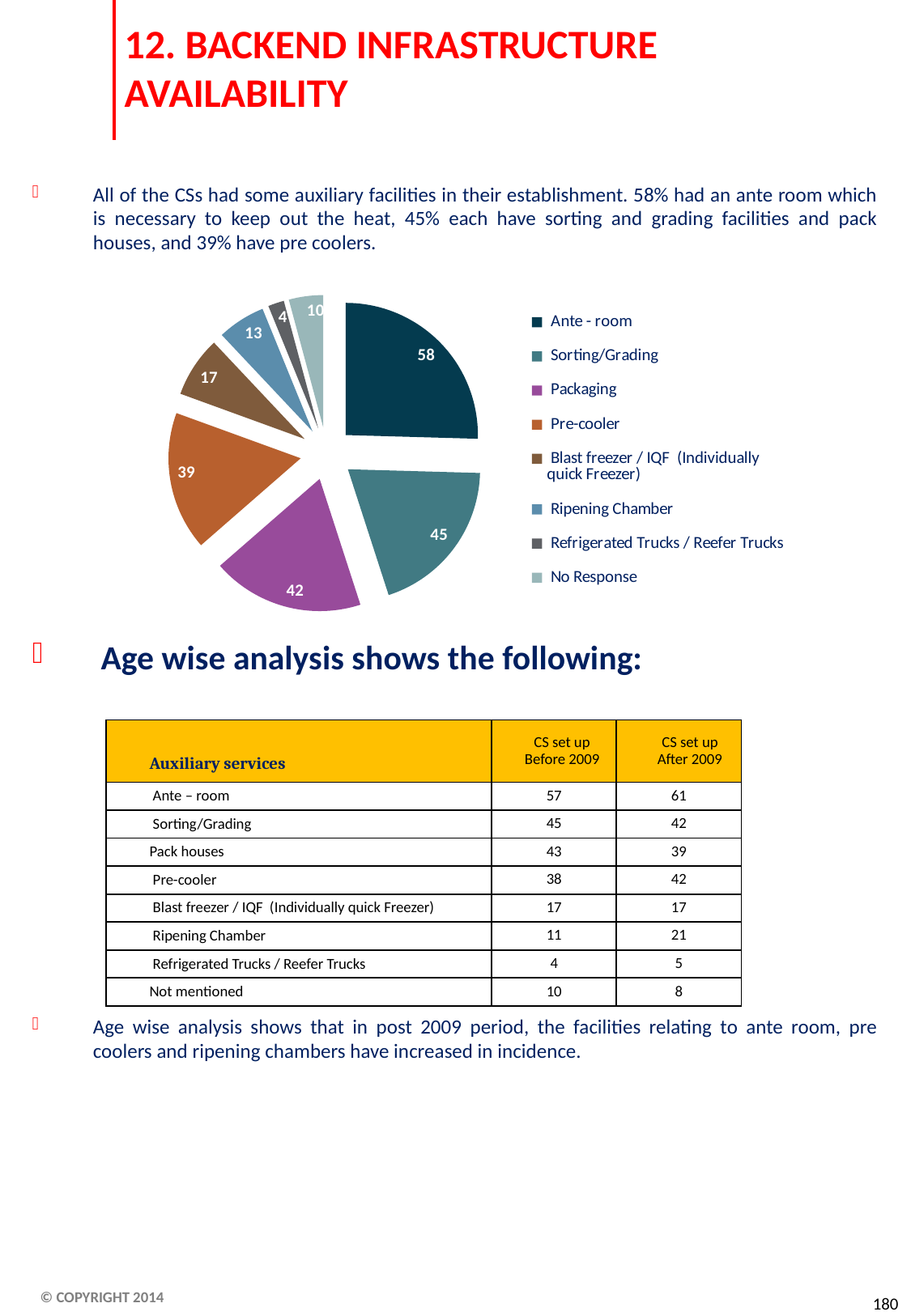
What is the value shown for the Packaging slice of the pie chart? 42 What is the value shown for the Ante - room slice of the pie chart? 58 What is the value shown for the No Response slice of the pie chart? 10 How many slices does the pie chart have? 8 Which category has the largest slice in the pie chart? Ante - room What is the difference between the Ante - room value and the Sorting/Grading value in the pie chart? 13 Which category has the smallest slice in the pie chart? Refrigerated Trucks / Reefer Trucks Which is larger in the pie chart, the Blast freezer / IQF slice or the Ripening Chamber slice? Blast freezer / IQF (Individually quick Freezer) How many entries does the pie chart's legend list? 8 What is the value shown for the Pre-cooler slice of the pie chart? 39 What is the value shown for the Ripening Chamber slice of the pie chart? 13 What type of chart is shown on the slide? Pie chart